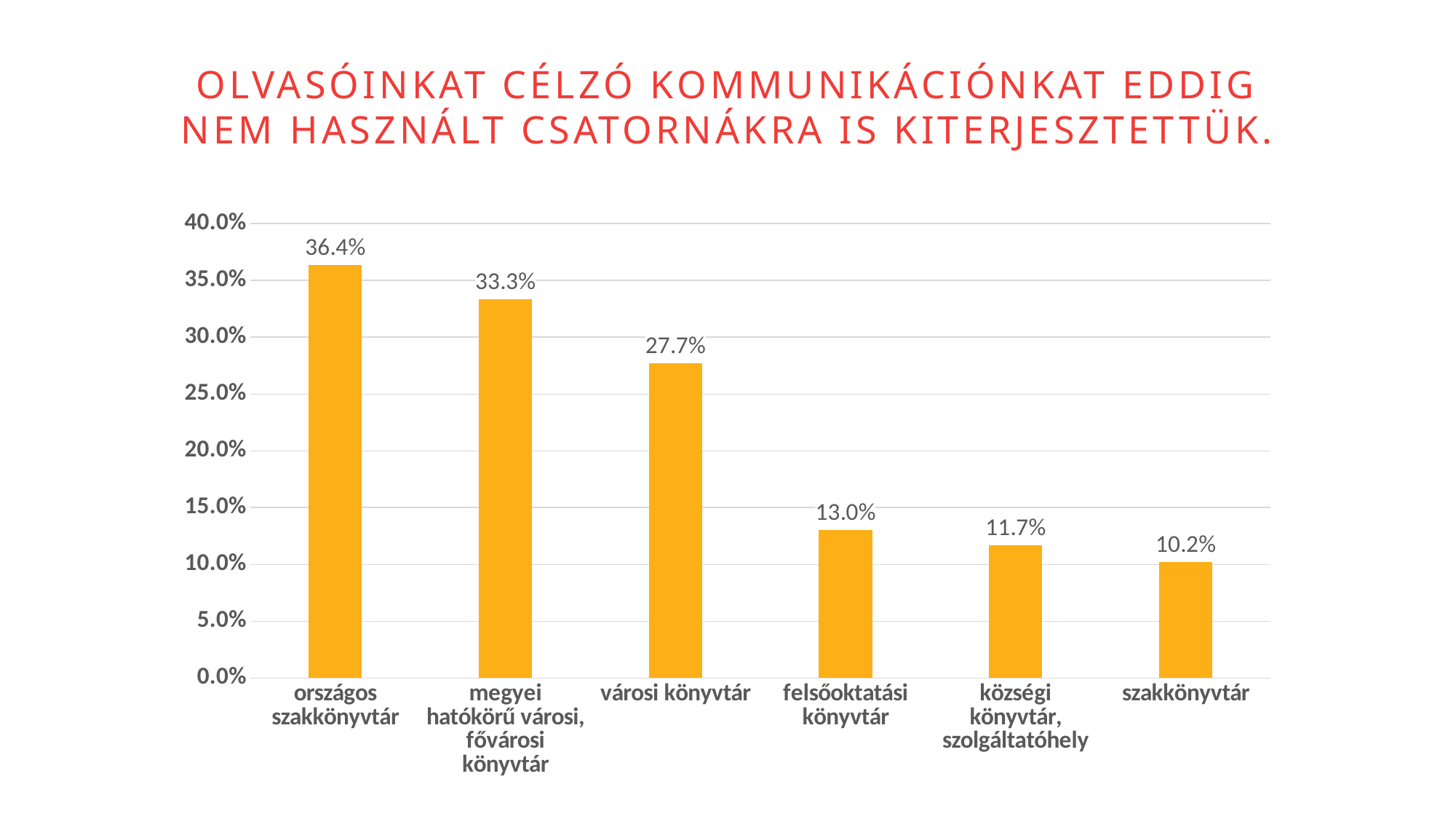
What is the value for országos szakkönyvtár? 36.4% What is the value for városi könyvtár? 27.7% What is the difference between the values for országos szakkönyvtár and megyei hatókörű városi, fővárosi könyvtár? 3.1% Which category has the highest value? országos szakkönyvtár What kind of chart is shown on the slide? bar chart Which is larger, the value for városi könyvtár or the value for felsőoktatási könyvtár? városi könyvtár How many categories are shown on the x axis? 6 What is the value for szakkönyvtár? 10.2% Do the values rise or fall from left to right along the x axis? fall Which category has the lowest value? szakkönyvtár What is the value for községi könyvtár, szolgáltatóhely? 11.7% What is the difference between the values for felsőoktatási könyvtár and szakkönyvtár? 2.8%